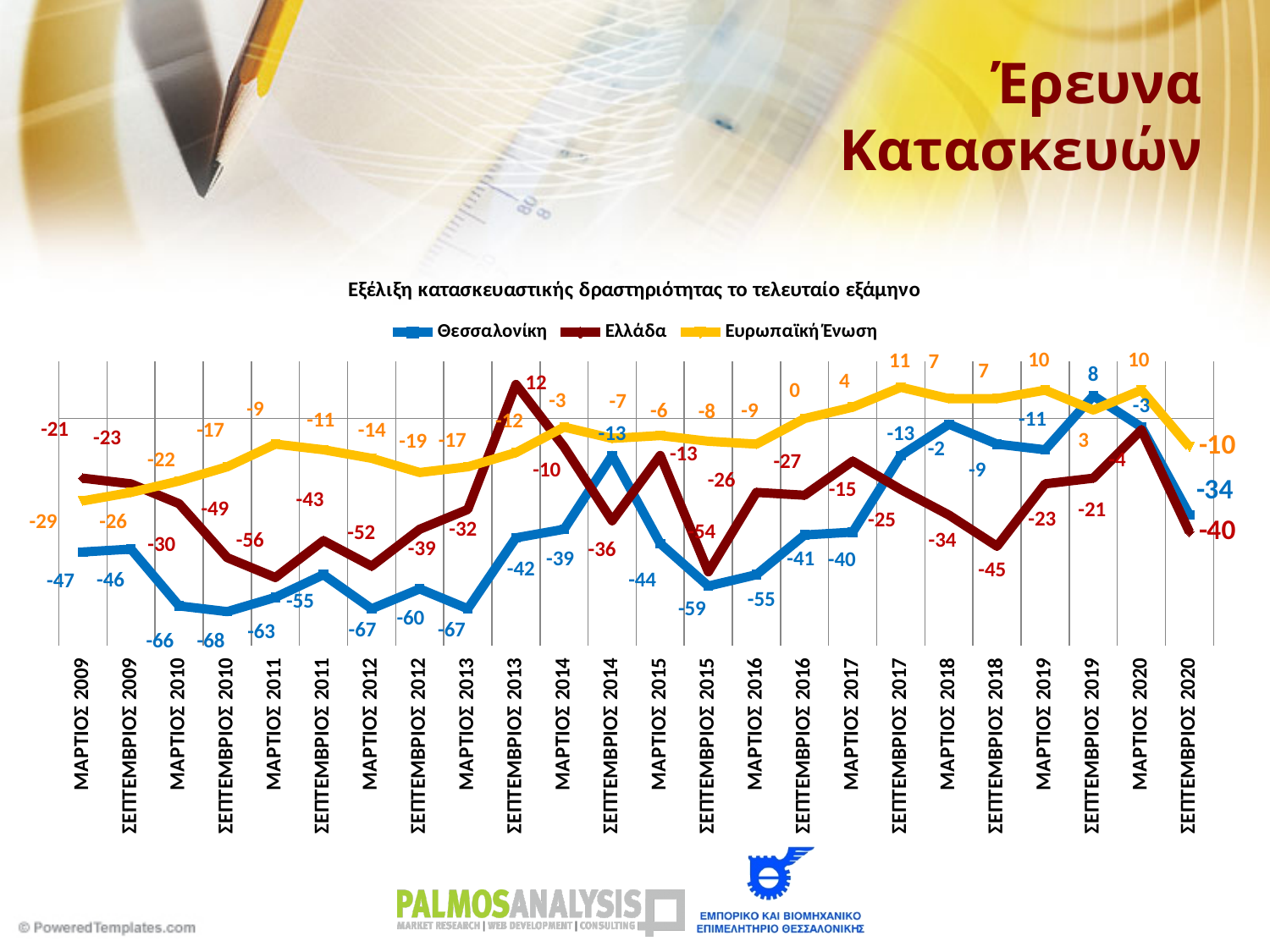
In which period does the Ελλάδα series reach its highest value? ΣΕΠΤΕΜΒΡΙΟΣ 2013 In which period does the Θεσσαλονίκη series reach its lowest value? ΣΕΠΤΕΜΒΡΙΟΣ 2010 In ΣΕΠΤΕΜΒΡΙΟΣ 2020, which is higher: Θεσσαλονίκη or Ελλάδα? Θεσσαλονίκη How many series does the legend list? 3 In which period does the Θεσσαλονίκη series reach its highest value? ΣΕΠΤΕΜΒΡΙΟΣ 2019 What is the difference between the Ελλάδα value and the Θεσσαλονίκη value in ΜΑΡΤΙΟΣ 2009? 26 How many time periods are shown on the x axis? 24 What is the value for Θεσσαλονίκη in ΣΕΠΤΕΜΒΡΙΟΣ 2020? -34 What kind of chart is shown on the slide? line chart What is the value for Ελλάδα in ΣΕΠΤΕΜΒΡΙΟΣ 2020? -40 What is the value for Θεσσαλονίκη in ΜΑΡΤΙΟΣ 2009? -47 What is the value for Ευρωπαϊκή Ένωση in ΣΕΠΤΕΜΒΡΙΟΣ 2020? -10